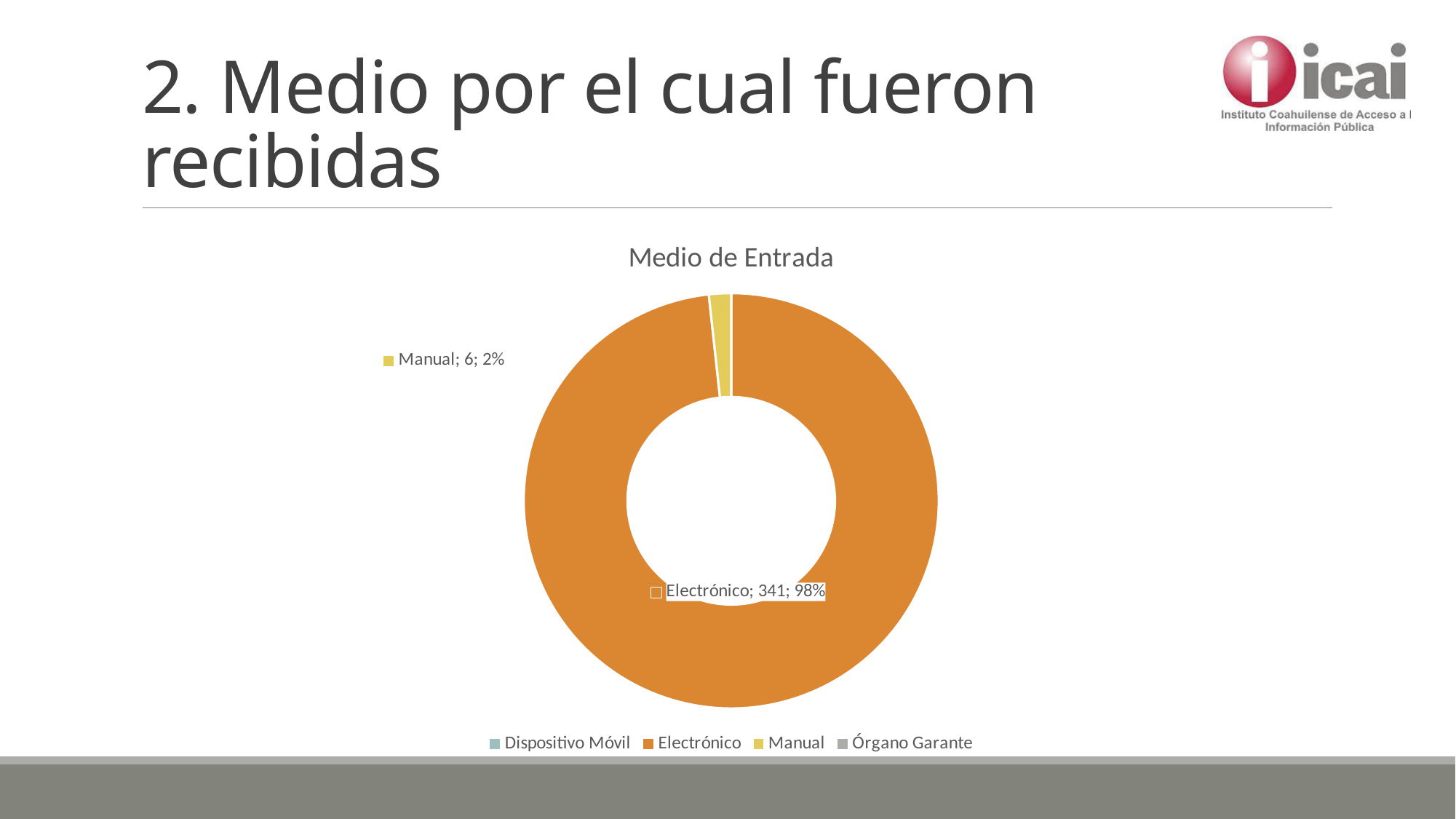
How many categories does the legend of the Medio de Entrada chart list? 4 What is the value for Manual in the Medio de Entrada chart? 6 What share of the Medio de Entrada chart does Manual represent? 2% What is the difference between the Electrónico and Manual values in the Medio de Entrada chart? 335 What share of the Medio de Entrada chart does Electrónico represent? 98% What is the total of the Electrónico and Manual values in the Medio de Entrada chart? 347 What kind of chart is shown on the slide? Doughnut chart What colour is the Electrónico slice in the Medio de Entrada chart? Orange What is the title of the chart on the slide? Medio de Entrada What is the value for Electrónico in the Medio de Entrada chart? 341 Which is larger in the Medio de Entrada chart, Electrónico or Manual? Electrónico Which category has the largest slice in the Medio de Entrada chart? Electrónico